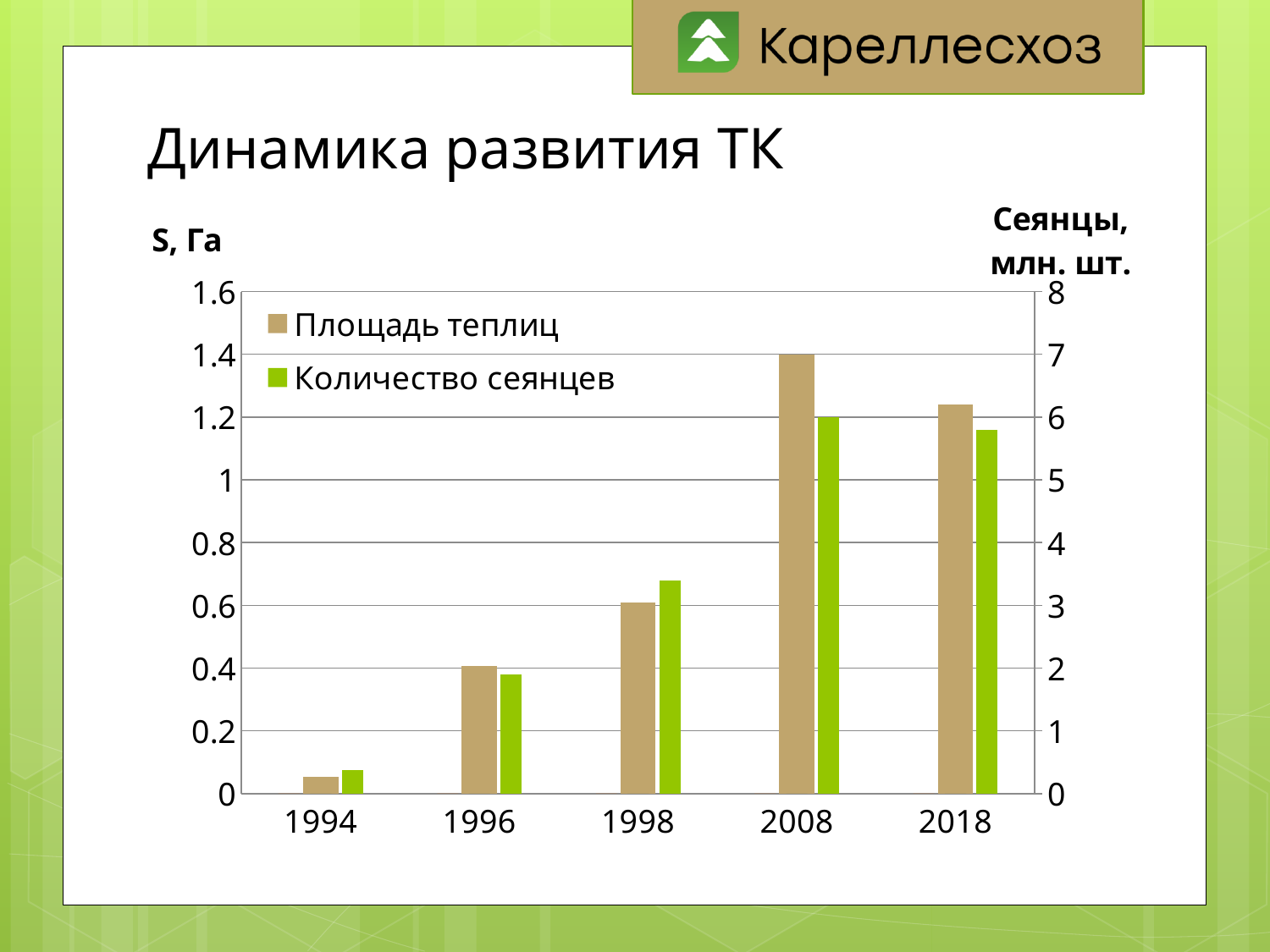
How many series does the chart legend list? 2 What is the value for Количество сеянцев in 2008? 6 What is the label of the right-hand vertical axis? Сеянцы, млн. шт. In which year is the value for Площадь теплиц the highest? 2008 What is the value for Площадь теплиц in 2008? 1.4 Is the value for Площадь теплиц in 1996 greater or less than 0.6? less How many years are shown on the x axis of the chart? 5 What type of chart is shown on the slide? Bar chart Is the value for Количество сеянцев in 1998 greater or less than 3? greater What is the title of the chart on the slide? Динамика развития ТК In which year is the value for Количество сеянцев the lowest? 1994 Which is larger: Площадь теплиц in 1996 or in 1998? 1998